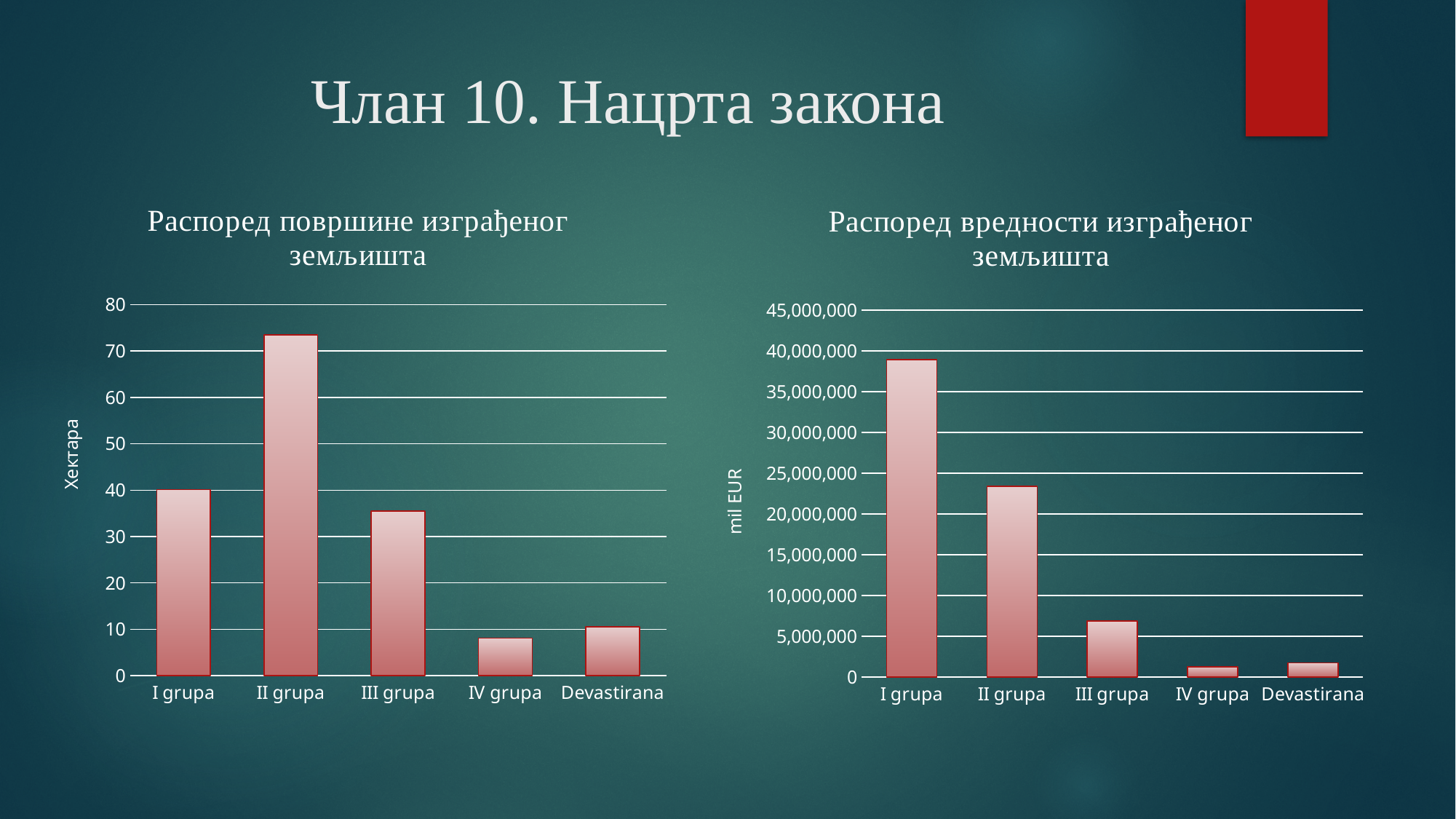
In the chart titled 'Распоред вредности изграђеног земљишта', which category has the lowest value? IV grupa In the left chart, is the value for II grupa greater or less than 70? greater In the chart titled 'Распоред површине изграђеног земљишта', which category has the lowest value? IV grupa In the chart titled 'Распоред површине изграђеног земљишта', which category has the highest value? II grupa In the chart titled 'Распоред вредности изграђеног земљишта', which category has the highest value? I grupa What type of chart is the chart titled 'Распоред вредности изграђеног земљишта'? bar chart In the right chart, is the value for II grupa greater or less than 25,000,000? less In the right chart, is the value for I grupa greater or less than 35,000,000? greater How many categories are shown on the x axis of the left chart? 5 In the left chart, which is larger, the value for I grupa or the value for III grupa? I grupa What is the y-axis label of the left chart? Хектара